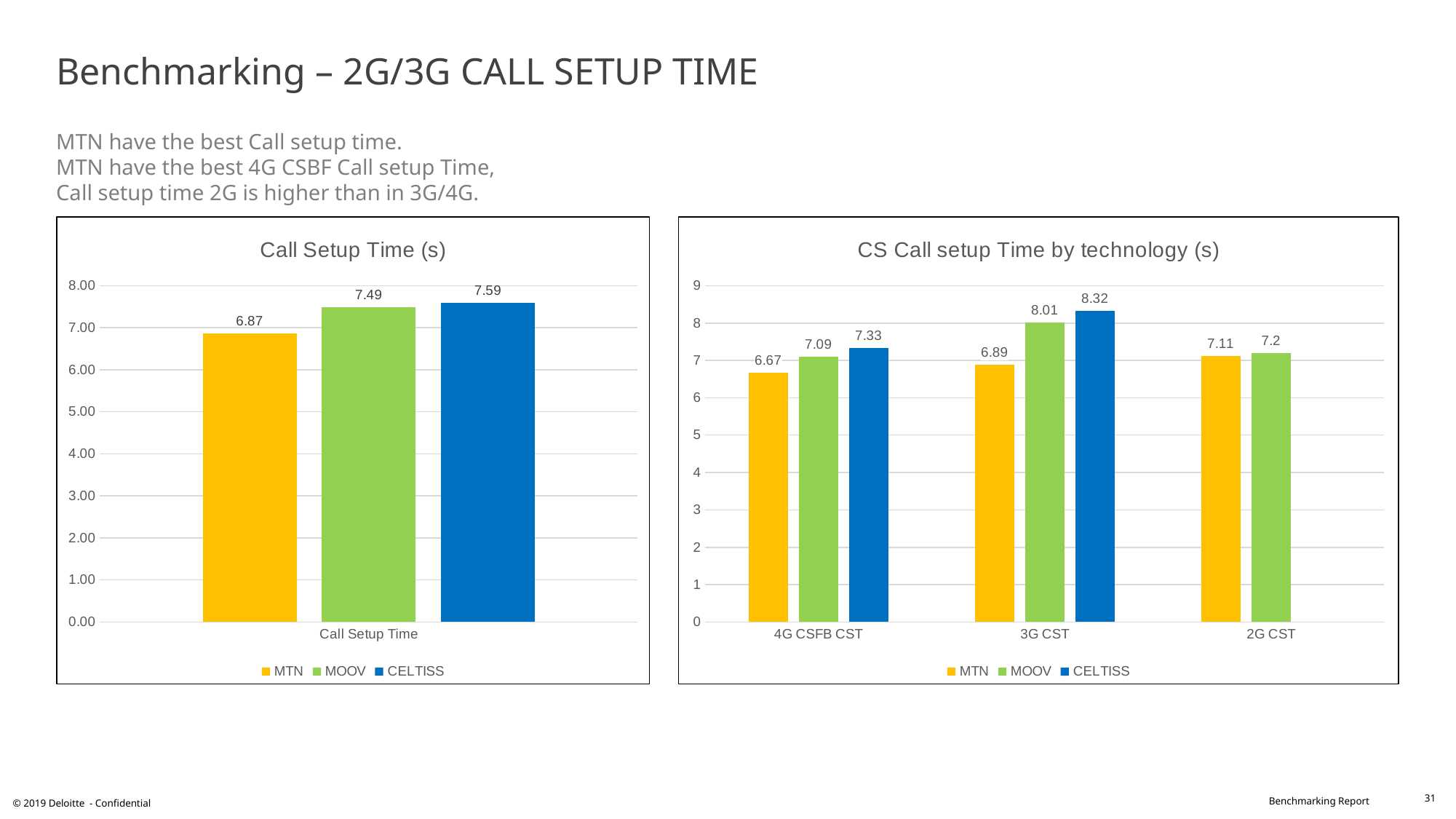
In the 'CS Call setup Time by technology (s)' chart, which operator has no bar at 2G CST? CELTISS In the 'CS Call setup Time by technology (s)' chart, which is larger: MTN at 2G CST or MTN at 3G CST? MTN at 2G CST In the 'CS Call setup Time by technology (s)' chart, what is the value for MOOV at 3G CST? 8.01 In the 'CS Call setup Time by technology (s)' chart, what is the value for CELTISS at 4G CSFB CST? 7.33 In the 'CS Call setup Time by technology (s)' chart, what is the difference between CELTISS and MTN at 3G CST? 1.43 In the 'CS Call setup Time by technology (s)' chart, which operator has the lowest value at 4G CSFB CST? MTN In the 'CS Call setup Time by technology (s)' chart, how many technology categories are shown on the x axis? 3 What kind of chart is 'CS Call setup Time by technology (s)'? Bar chart In the 'Call Setup Time (s)' chart, how many series does the legend list? 3 In the 'Call Setup Time (s)' chart, which operator has the highest call setup time? CELTISS In the 'Call Setup Time (s)' chart, what is the difference between CELTISS and MTN? 0.72 In the 'Call Setup Time (s)' chart, what is the value for MTN? 6.87